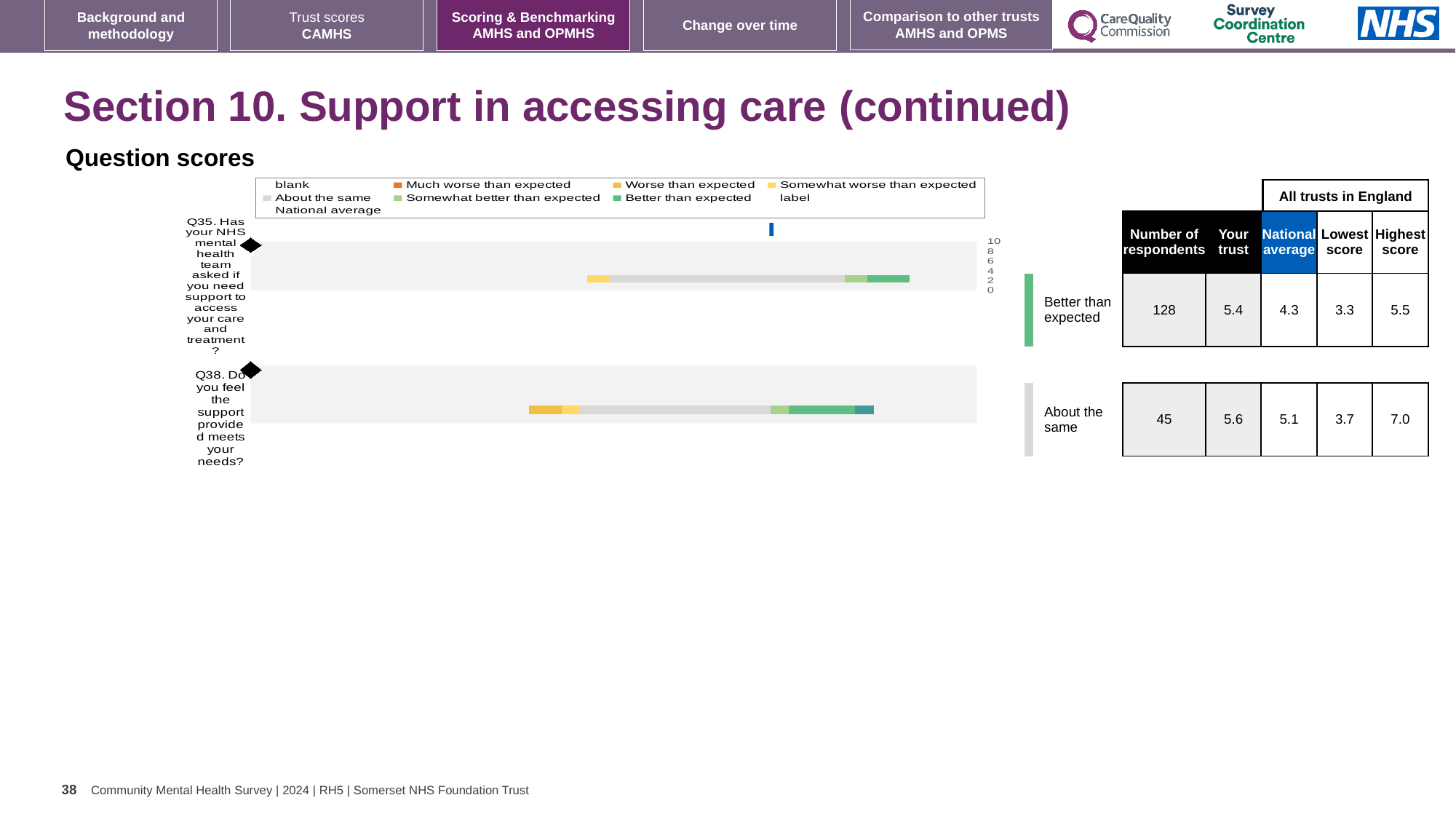
In the table beside the chart, what is the national average for Q35? 4.3 What is the highest tick value shown on the axis of the question scores chart? 10 In the table beside the chart, how many respondents are shown for Q35? 128 What kind of chart is used to show the question scores on this slide? bar chart How many entries does the legend of the question scores chart list? 9 In the table beside the chart, what is the highest score for Q38? 7.0 In the table beside the chart, what is the 'Your trust' score for Q38? 5.6 How many questions (categories) are plotted in the question scores chart? 2 In the legend of the question scores chart, what colour represents 'Much worse than expected'? orange In the table beside the chart, what is the lowest score for Q35? 3.3 In the table beside the chart, what is the difference between the 'Your trust' score and the national average for Q35? 1.1 Which question has more respondents in the table beside the chart, Q35 or Q38? Q35